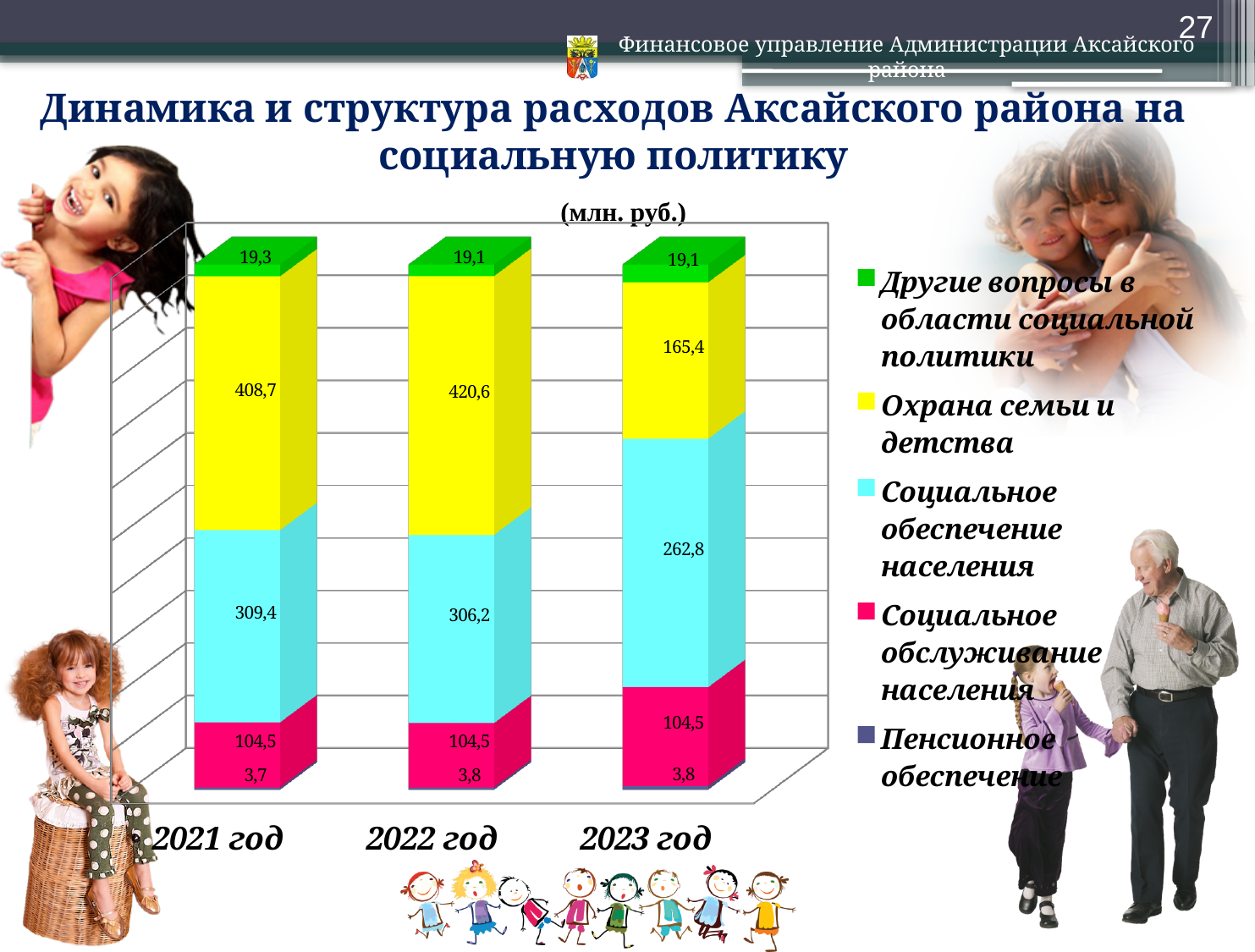
How many years (categories) are shown on the x axis? 3 What is the difference between the Охрана семьи и детства values for 2022 год and 2023 год? 255,2 What is the value for Охрана семьи и детства in 2022 год? 420,6 What is the value for Пенсионное обеспечение in 2021 год? 3,7 What is the value for Социальное обеспечение населения in 2023 год? 262,8 What unit is stated above the chart? млн. руб. What is the total of the stacked bar for 2023 год? 555,6 In which year is the value for Охрана семьи и детства the lowest? 2023 год In which year is the value for Охрана семьи и детства the highest? 2022 год How many series does the legend list? 5 What type of chart is shown on the slide? Stacked bar chart Which is larger: Социальное обеспечение населения in 2021 год or in 2023 год? 2021 год